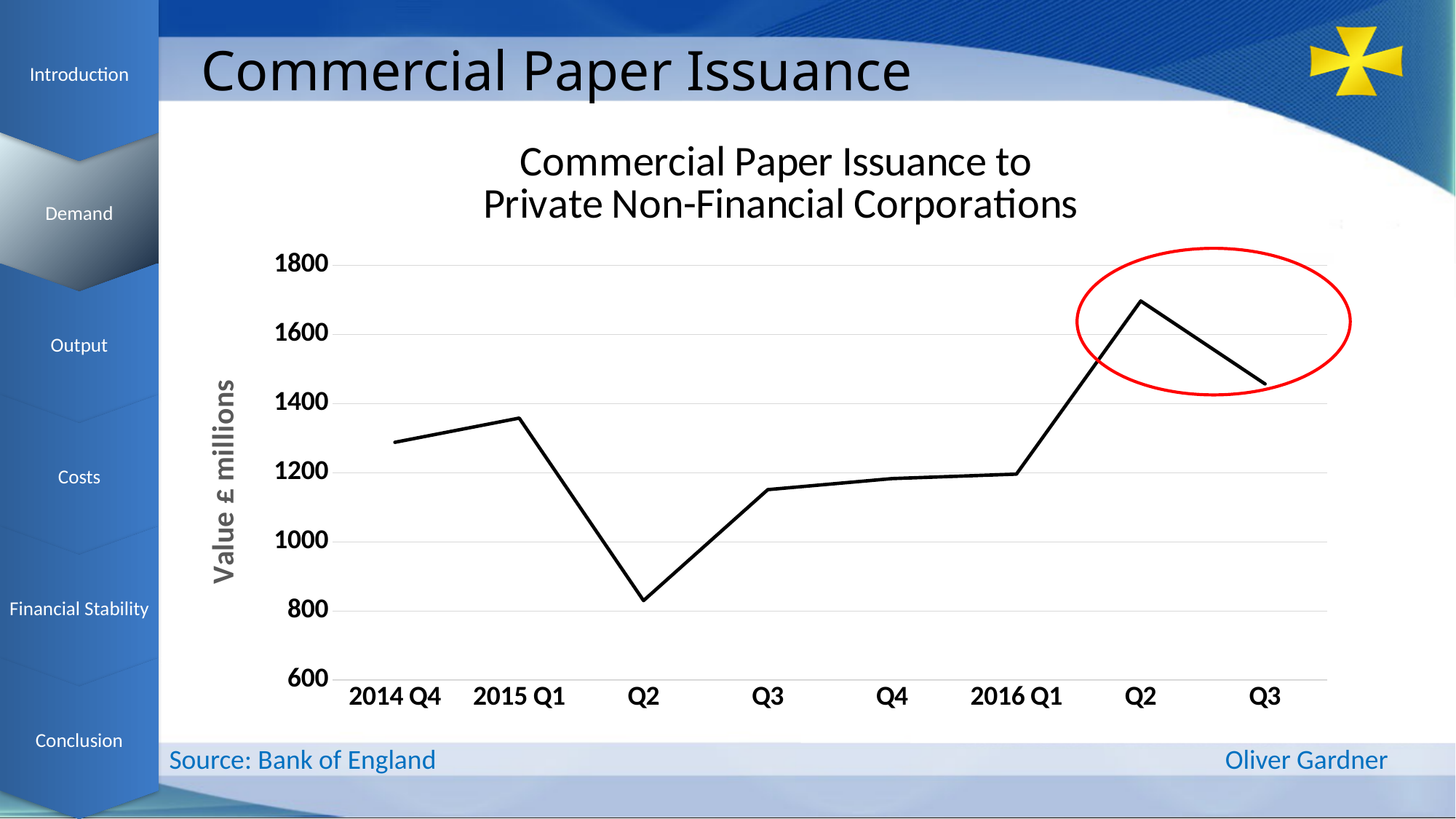
Is the value for 2014 Q4 greater or less than 1200? greater What kind of chart is shown on the slide? line chart What is the label on the y axis of the chart? Value £ millions Is the value for 2016 Q2 greater or less than 1600? greater Which quarter has the highest commercial paper issuance value? 2016 Q2 What is the source cited for the chart data? Bank of England How many quarters are plotted along the x axis? 8 Is the value for 2015 Q2 greater or less than 1000? less Does the value rise or fall from 2016 Q2 to 2016 Q3? fall Which quarter has the lowest commercial paper issuance value? 2015 Q2 Which is larger, the value for 2015 Q1 or the value for 2015 Q3? 2015 Q1